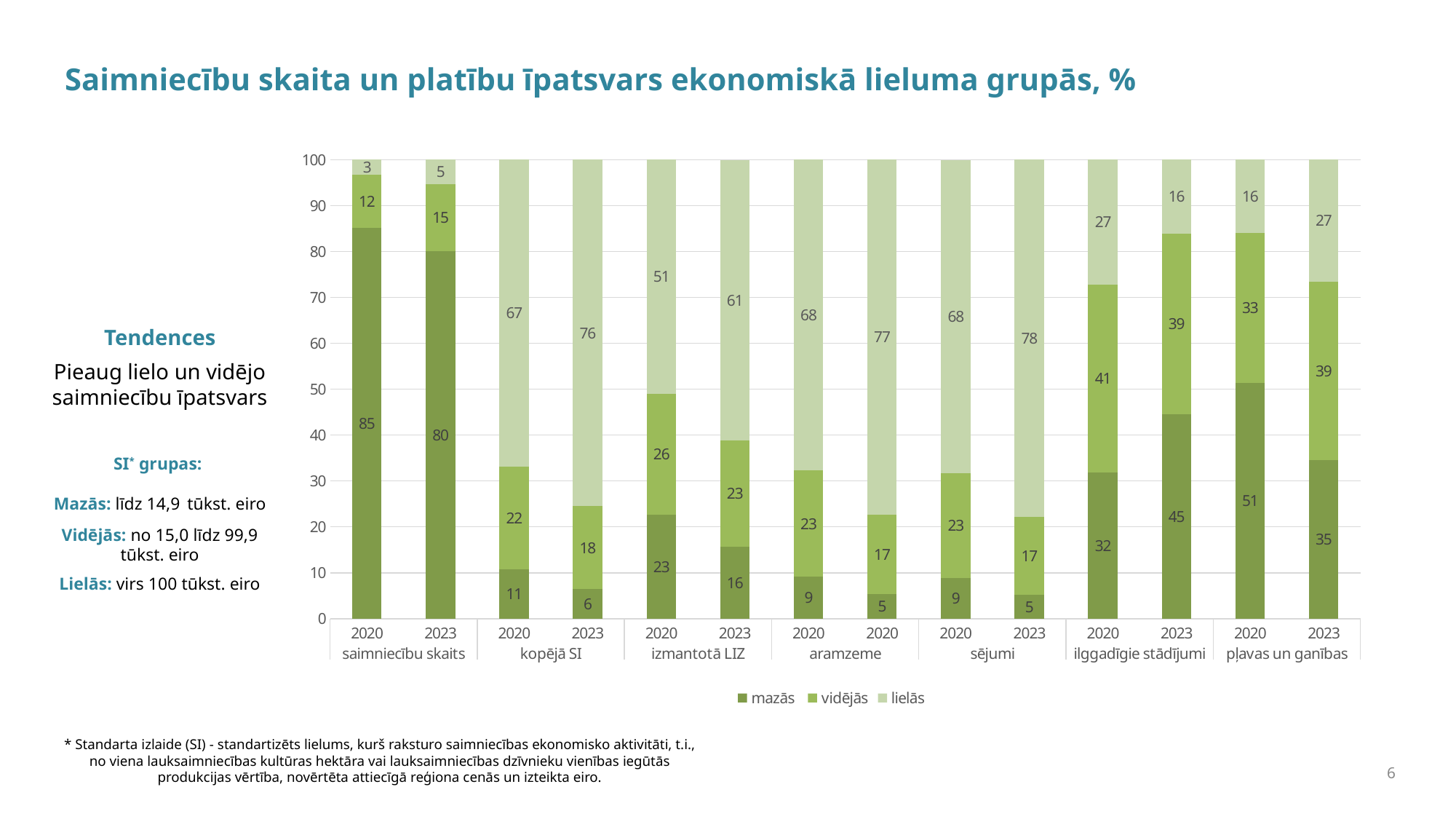
What kind of chart is shown on the slide? stacked bar chart Which bars have the lowest mazās value? aramzeme (second bar) and sējumi 2023, both 5 What is the value of the vidējās segment for ilggadīgie stādījumi in 2020? 41 What is the value of the lielās segment for kopējā SI in 2023? 76 How many series does the legend list? 3 What is the value of the mazās segment for saimniecību skaits in 2020? 85 How many bars are plotted in the chart? 14 What is the value of the mazās segment for pļavas un ganības in 2023? 35 What are the three series named in the legend? mazās, vidējās, lielās Which is larger: the mazās value for ilggadīgie stādījumi in 2023 or the mazās value for pļavas un ganības in 2020? pļavas un ganības 2020 What is the difference between the lielās values for izmantotā LIZ in 2023 and 2020? 10 Which bar has the highest mazās value? saimniecību skaits 2020